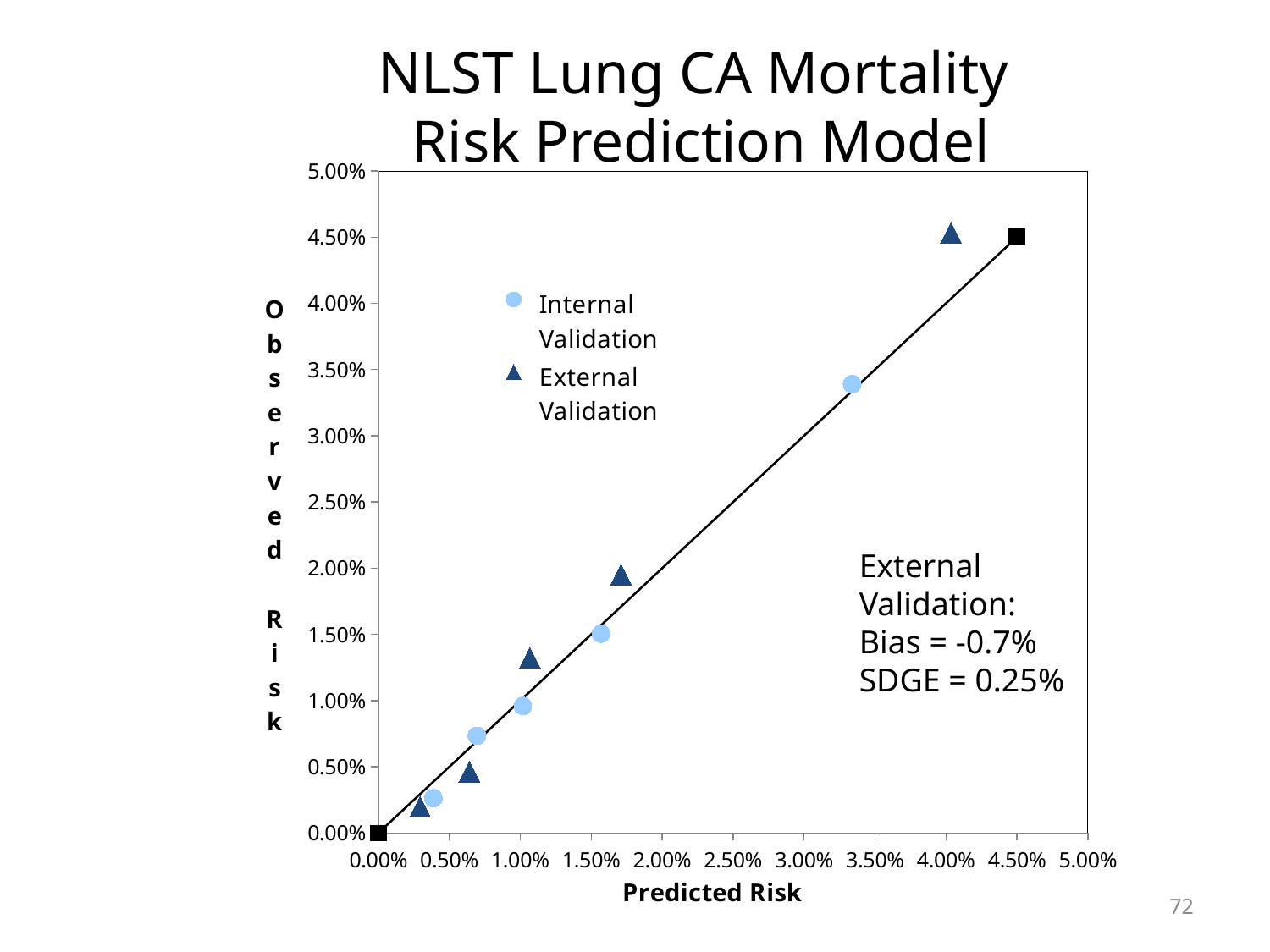
Is the observed risk of the lowest Internal Validation point greater or less than 0.50%? less What is the title of the chart? NLST Lung CA Mortality Risk Prediction Model What kind of chart is shown on the slide? scatter chart Does observed risk rise or fall as predicted risk increases along the x axis? rise How many series does the legend list? 2 Is the predicted risk of the highest External Validation point greater or less than 3.50%? greater Is the observed risk of the highest External Validation point greater or less than 4.00%? greater Which series contains the point with the highest observed risk, Internal Validation or External Validation? External Validation How many External Validation points are plotted? 5 What bias value is reported for External Validation in the chart annotation? -0.7% How many Internal Validation points are plotted? 5